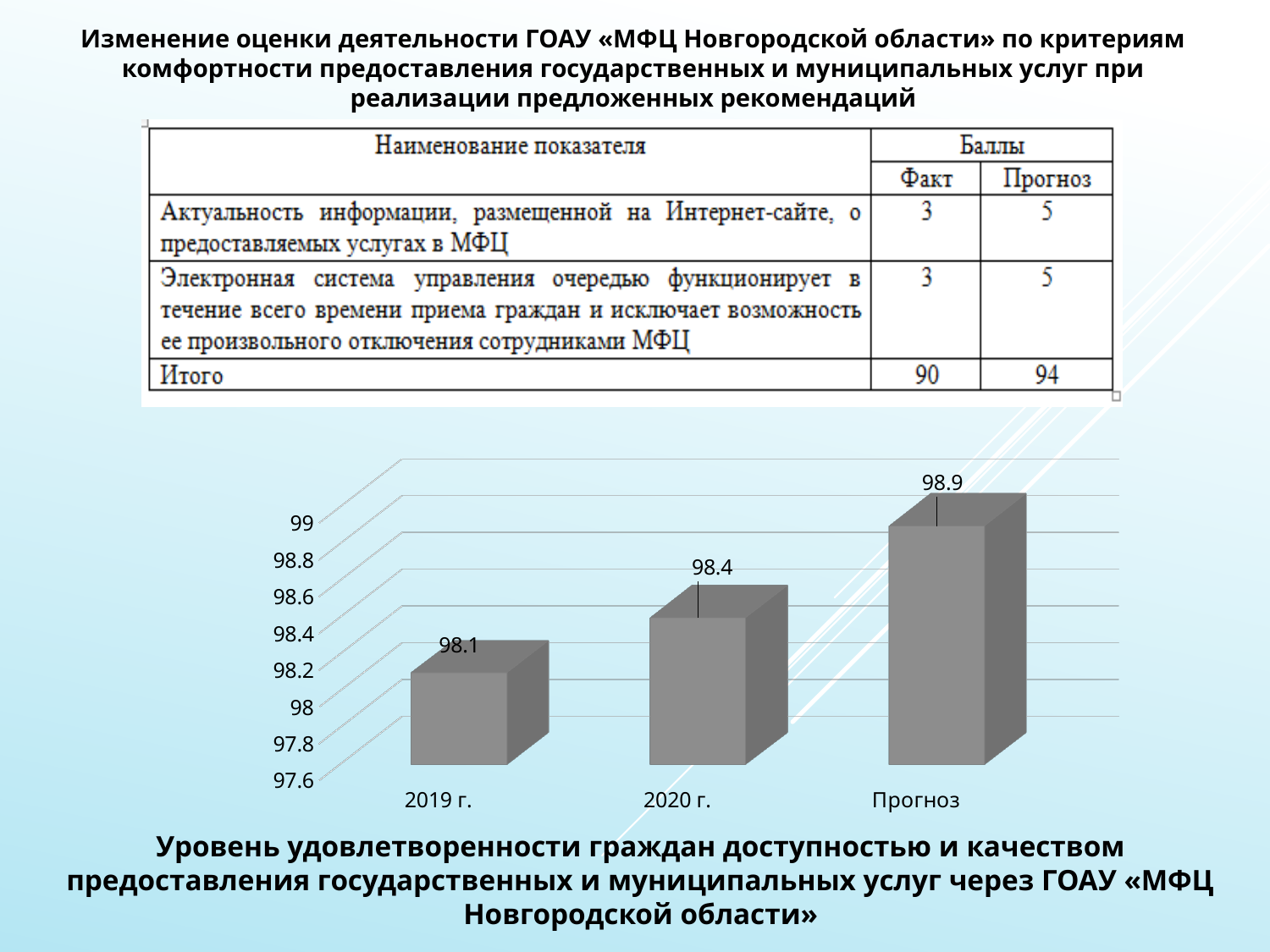
What is the value for 2019 г. in the chart? 98.1 What is the difference between the values for Прогноз and 2019 г.? 0.8 Do the values rise or fall from 2019 г. to Прогноз? rise What is the value for 2020 г. in the chart? 98.4 How many categories are shown in the chart? 3 What kind of chart is shown on the slide? bar chart Which is larger, the value for 2020 г. or the value for 2019 г.? 2020 г. Which category has the lowest value in the chart? 2019 г. What is the difference between the values for 2020 г. and 2019 г.? 0.3 Which category has the highest value in the chart? Прогноз Is the value for 2019 г. greater or less than 98.4? less What is the value for Прогноз in the chart? 98.9